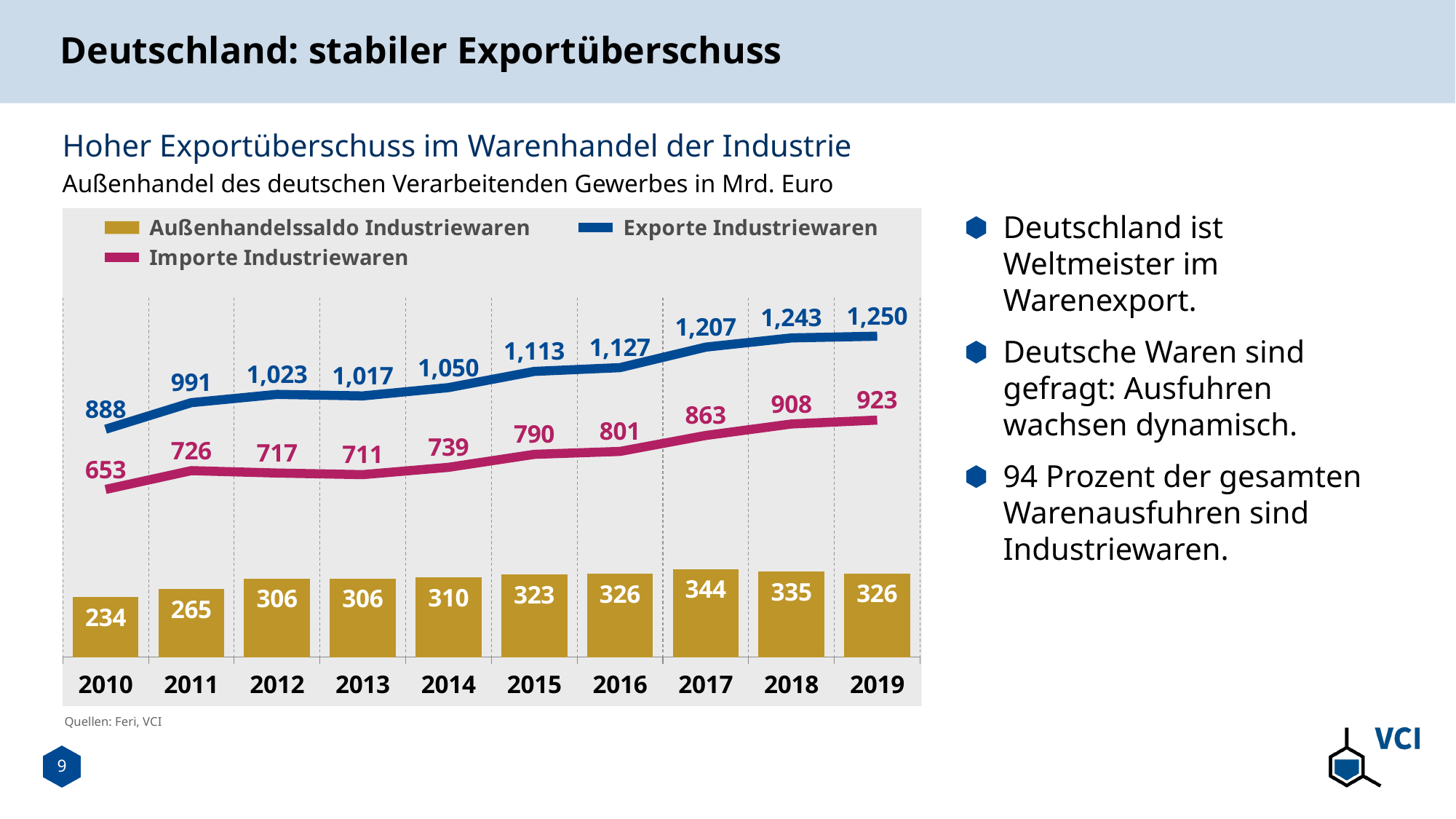
Which is larger: the Außenhandelssaldo Industriewaren in 2018 or in 2019? 2018 What is the difference between Exporte Industriewaren and Importe Industriewaren in 2017? 344 What colour is the Importe Industriewaren line? Magenta (pink-red) How many years are shown on the x axis? 10 What is the value of Importe Industriewaren in 2014? 739 In which year is the Importe Industriewaren value lowest? 2010 What is the value of Exporte Industriewaren in 2019? 1,250 What is the Außenhandelssaldo Industriewaren in 2010? 234 Do the Exporte Industriewaren values generally rise or fall from 2010 to 2019? Rise How many series does the legend list? 3 In which year is the Außenhandelssaldo Industriewaren highest? 2017 What kind of chart is used to show the Außenhandelssaldo Industriewaren? Bar chart